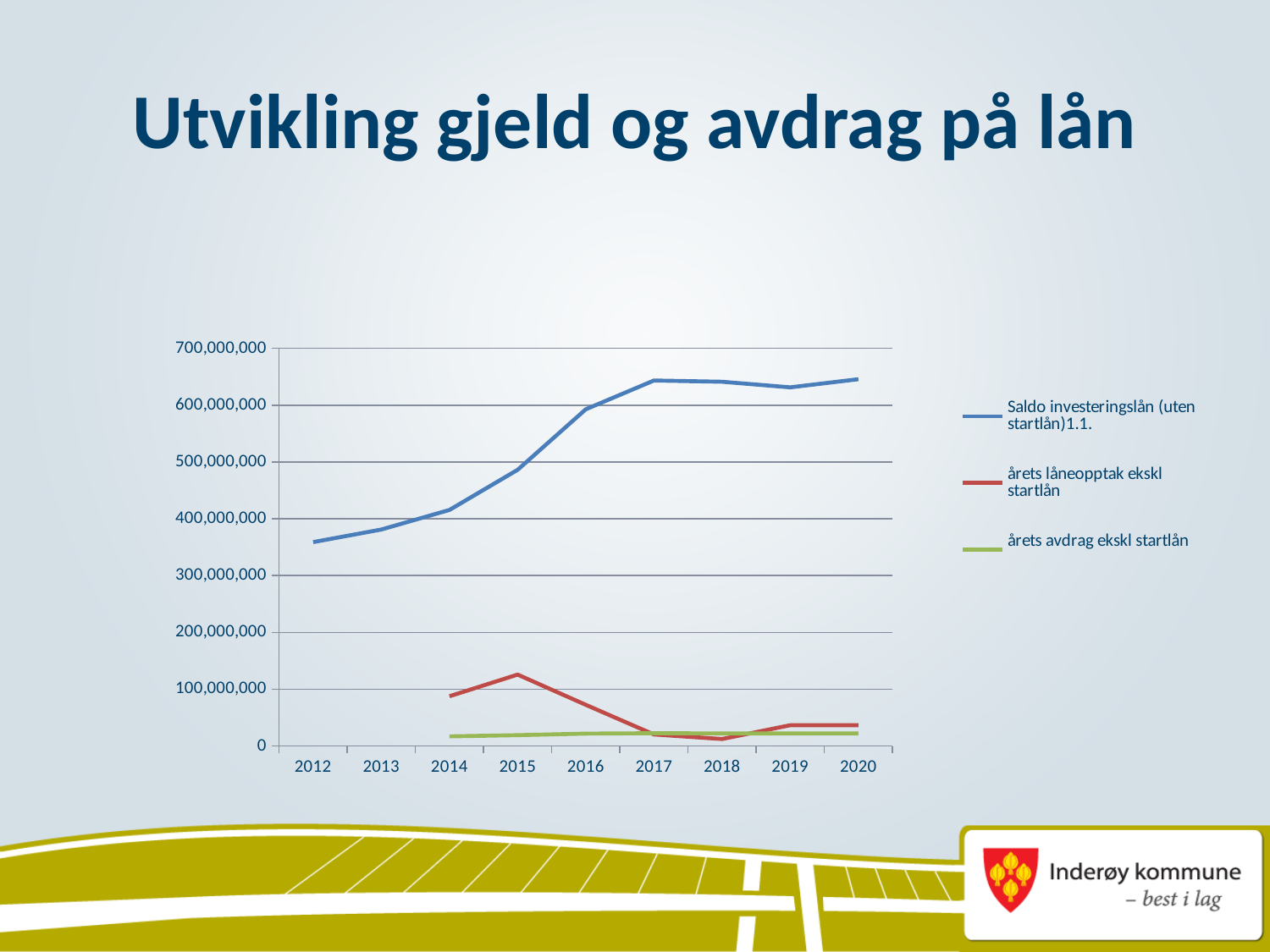
In which year is 'årets låneopptak ekskl startlån' at its highest? 2015 How many years are shown on the x axis? 9 Is the value for 'Saldo investeringslån (uten startlån)1.1.' in 2017 greater or less than 600,000,000? greater What kind of chart is shown on the slide? line chart Does 'Saldo investeringslån (uten startlån)1.1.' rise or fall from 2012 to 2017? rise In which year is 'Saldo investeringslån (uten startlån)1.1.' at its lowest? 2012 Is the value for 'årets låneopptak ekskl startlån' in 2015 greater or less than 100,000,000? greater Is the value for 'årets avdrag ekskl startlån' in 2014 greater or less than 100,000,000? less What is the title of the slide containing the chart? Utvikling gjeld og avdrag på lån Which series is drawn in red in the legend? årets låneopptak ekskl startlån How many series does the legend list? 3